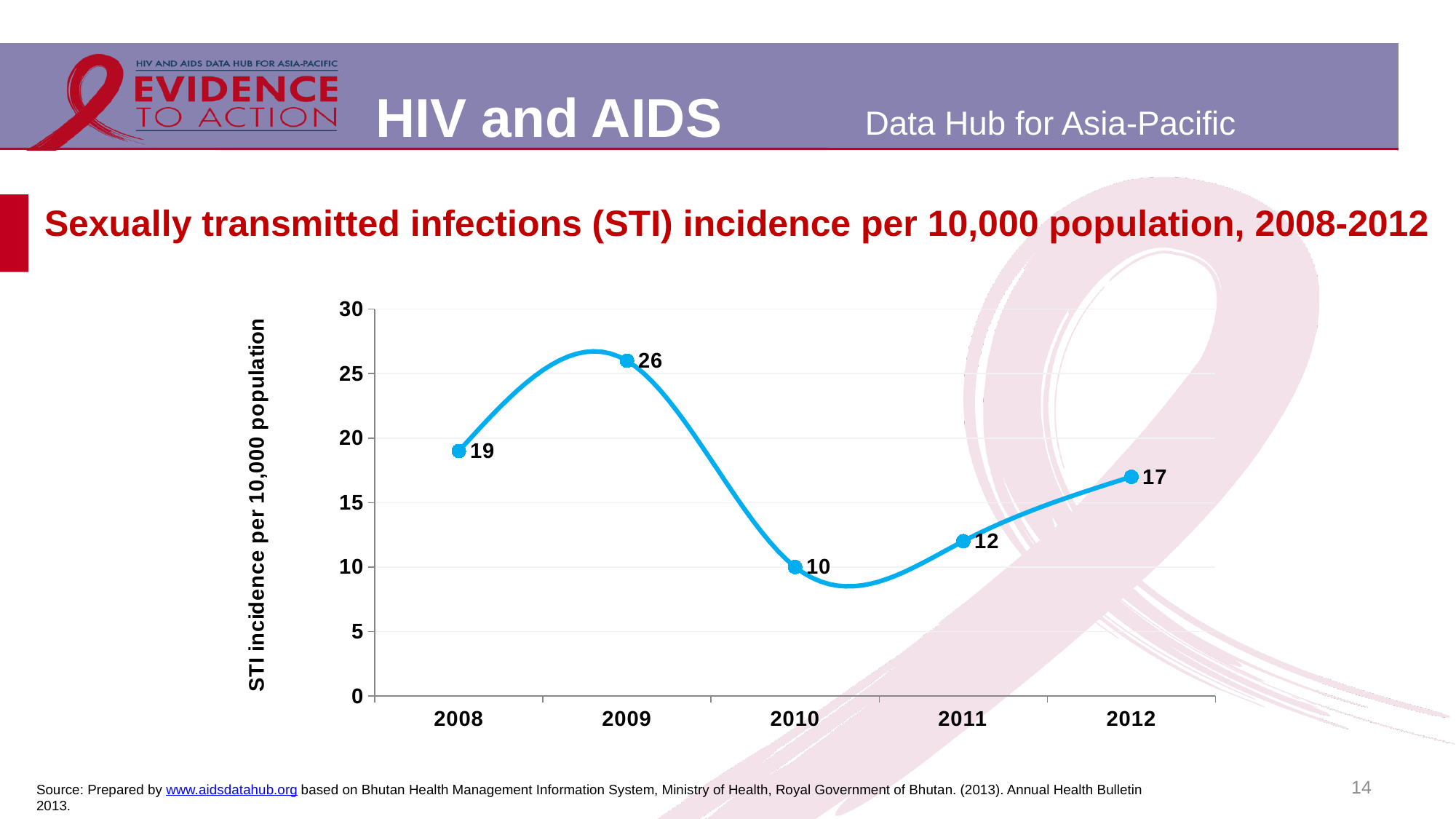
How many years are plotted on the chart? 5 Which year had the highest STI incidence per 10,000 population? 2009 What was the STI incidence per 10,000 population in 2012? 17 What was the STI incidence per 10,000 population in 2008? 19 Which year had the lowest STI incidence per 10,000 population? 2010 What was the STI incidence per 10,000 population in 2009? 26 What is the difference in STI incidence per 10,000 population between 2012 and 2011? 5 By how much did the STI incidence per 10,000 population fall from 2009 to 2010? 16 What kind of chart is shown on the slide? line chart Which year had a higher STI incidence per 10,000 population, 2008 or 2012? 2008 Is the STI incidence per 10,000 population in 2011 greater or less than 15? less Did the STI incidence per 10,000 population rise or fall between 2010 and 2012? rise